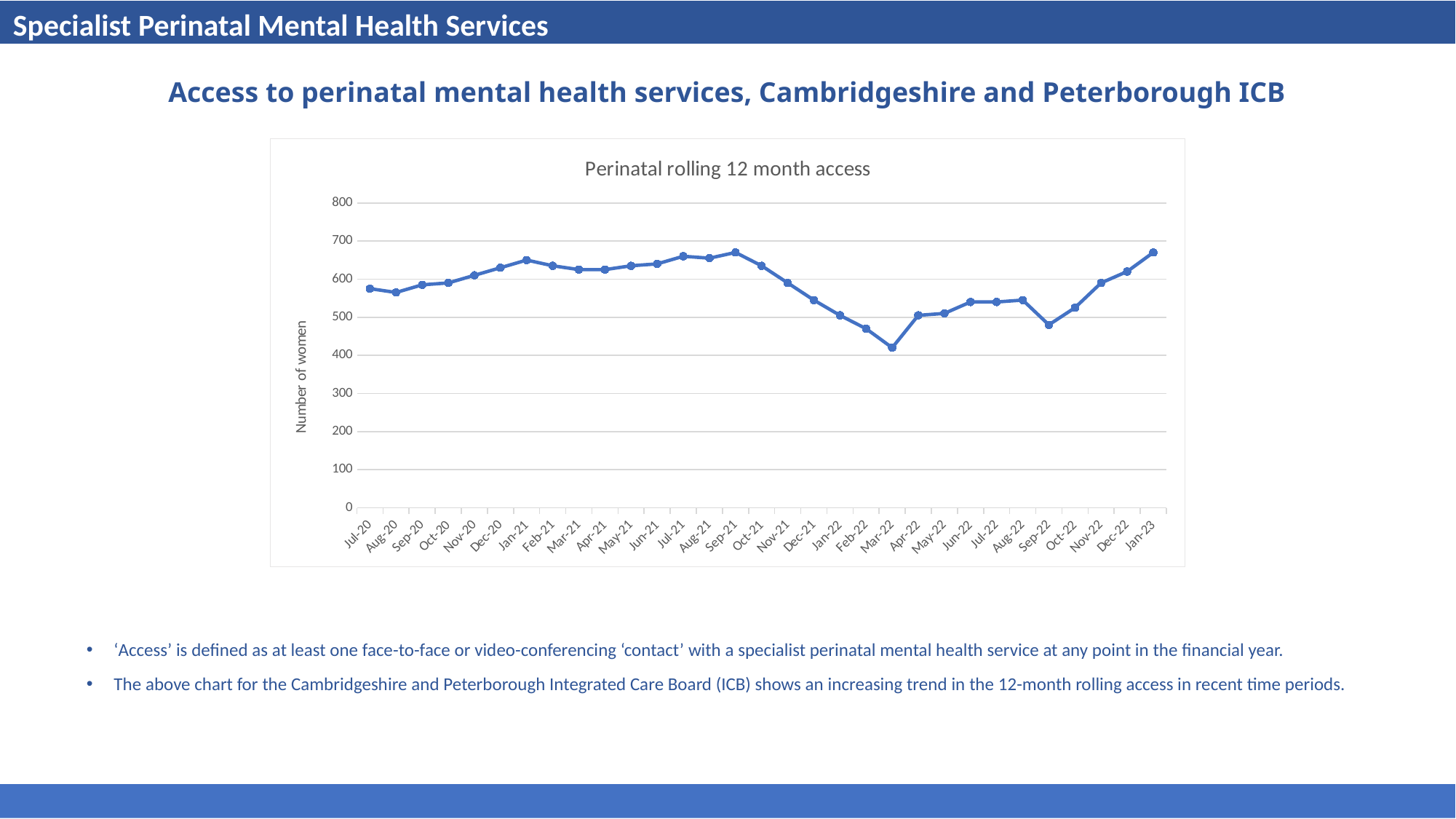
What kind of chart is shown on the slide? Line chart What is the label on the vertical axis of the chart? Number of women How many monthly data points are plotted on the chart? 31 Which is larger, the value for Jul-21 or the value for Sep-22? Jul-21 Do the values rise or fall between Jul-20 and Jan-21? rise Do the values rise or fall between Sep-21 and Mar-22? fall Is the value for Jan-23 greater or less than 600? greater Which month has the lowest value on the chart? Mar-22 Is the value for Jan-21 greater or less than 600? greater Is the value for Sep-22 greater or less than 500? less What is the title of the chart? Perinatal rolling 12 month access